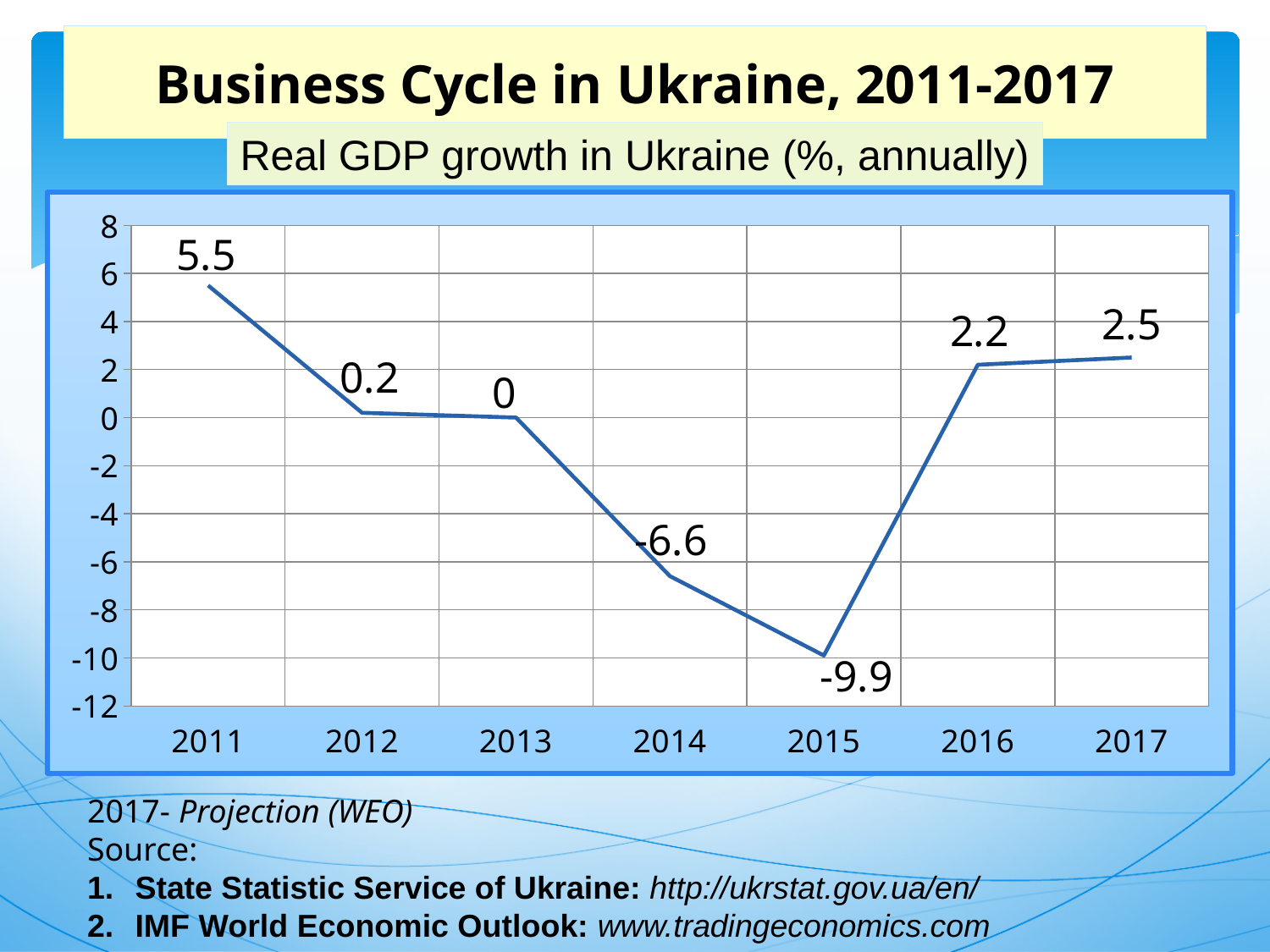
What was real GDP growth in Ukraine in 2011? 5.5 What type of chart is shown on the slide? Line chart Did real GDP growth rise or fall from 2011 to 2015? Fall What was real GDP growth in Ukraine in 2014? -6.6 How many years are plotted on the chart? 7 Which year had higher real GDP growth, 2012 or 2016? 2016 What is the difference between real GDP growth in 2011 and 2015? 15.4 What is the projected real GDP growth for Ukraine in 2017? 2.5 What was real GDP growth in Ukraine in 2015? -9.9 Which year had the lowest real GDP growth? 2015 What is the difference between real GDP growth in 2017 and 2016? 0.3 Which year had the highest real GDP growth? 2011